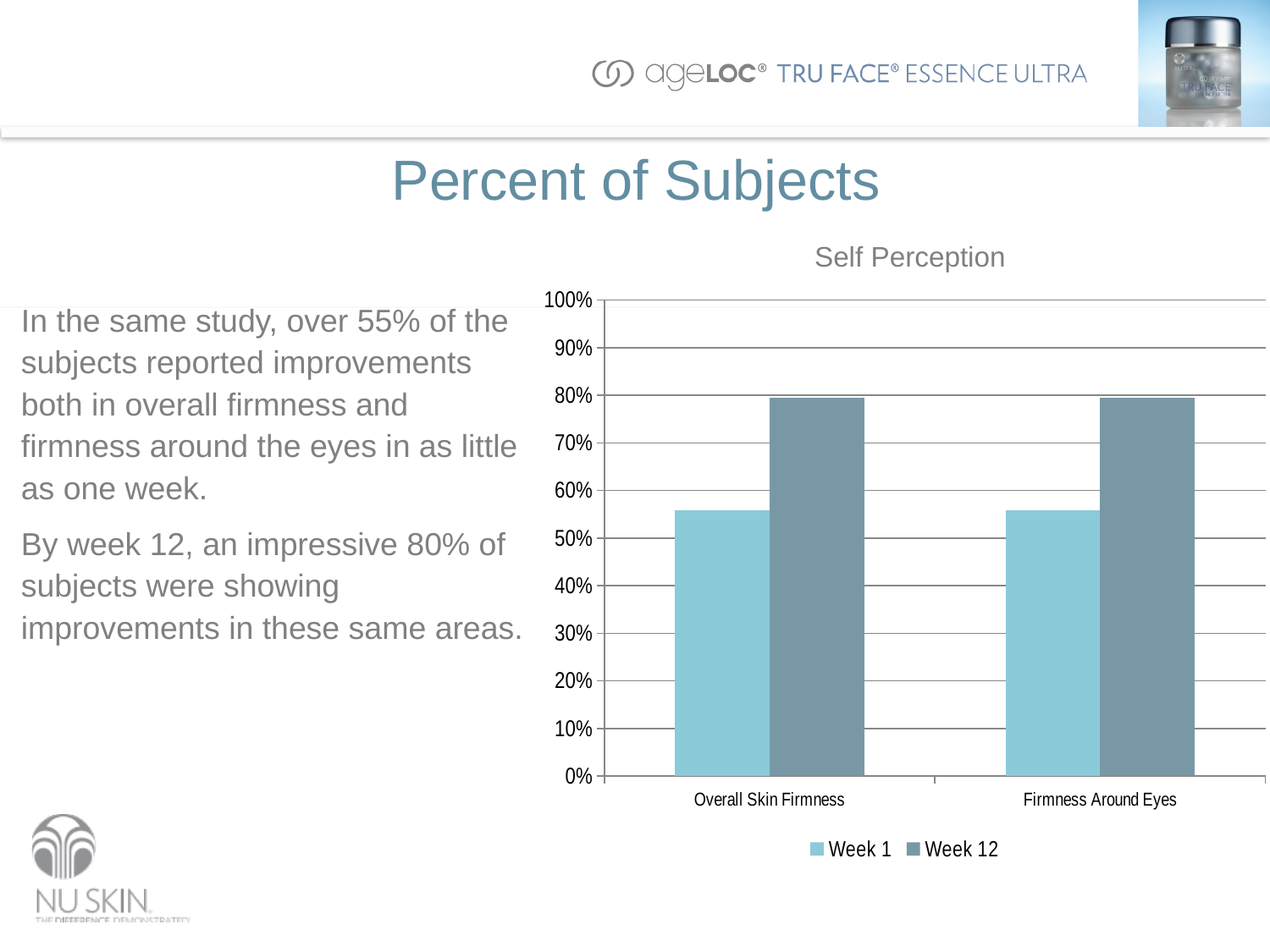
How many categories are shown on the x axis of the chart? 2 For Firmness Around Eyes, which series has the lower value? Week 1 Is the Week 12 value for Overall Skin Firmness greater or less than 70%? greater What are the two series listed in the chart's legend? Week 1 and Week 12 Is the Week 12 value for Firmness Around Eyes greater or less than 90%? less How many series does the chart's legend list? 2 What kind of chart is shown on the slide? bar chart What is the title of the chart? Self Perception Is the Week 1 value for Overall Skin Firmness greater or less than 50%? greater For Overall Skin Firmness, which is larger: the Week 1 value or the Week 12 value? Week 12 Which series has the highest bar in the chart? Week 12